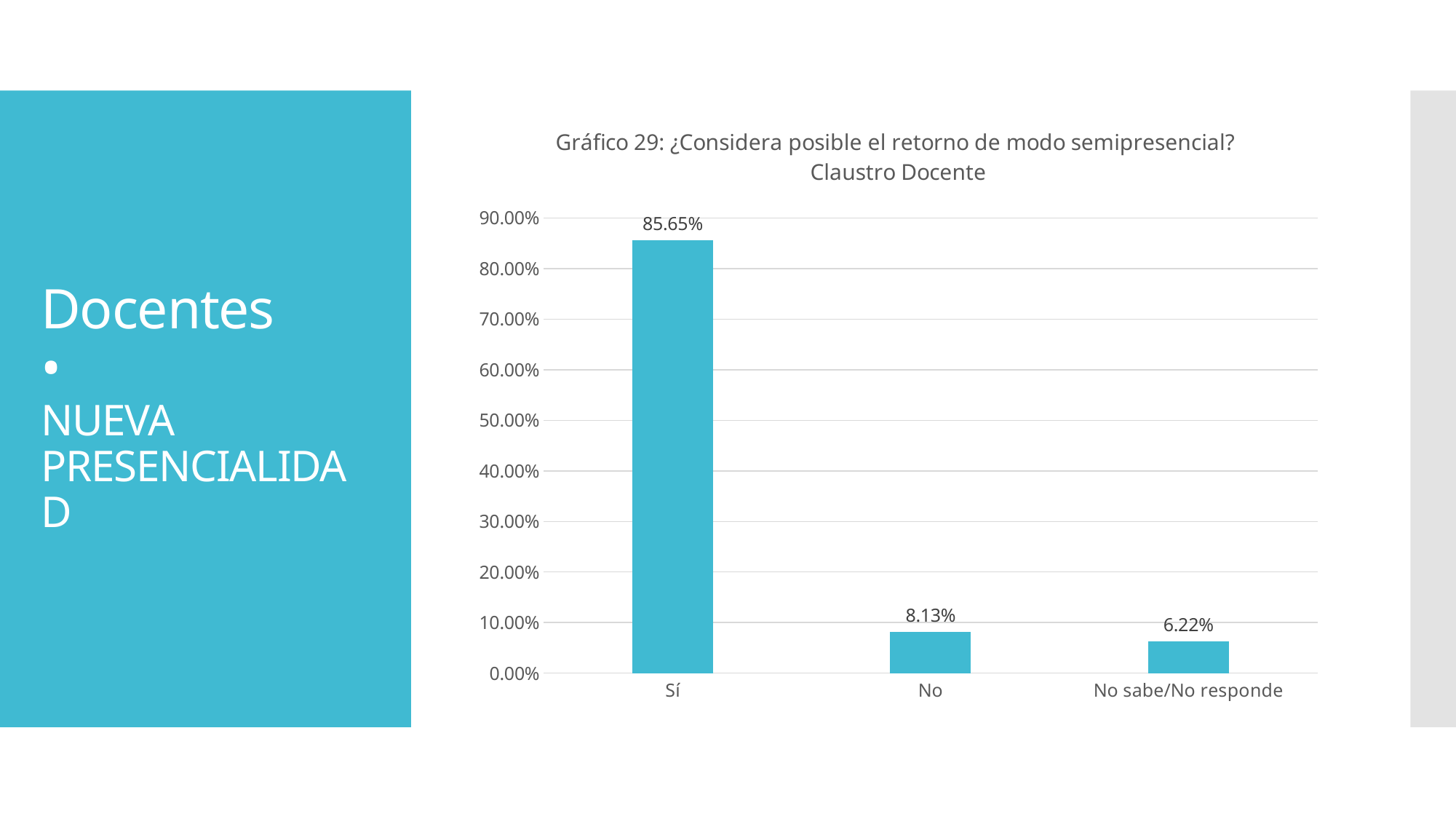
What is the difference between the values for Sí and No? 77.52% What is the value for Sí? 85.65% What is the difference between the values for No and No sabe/No responde? 1.91% What is the title of the chart? Gráfico 29: ¿Considera posible el retorno de modo semipresencial? Claustro Docente Is the value for Sí greater or less than 80.00%? greater Which category has the lowest value? No sabe/No responde Which is larger, the value for No or the value for No sabe/No responde? No What is the value for No? 8.13% How many categories are shown on the x axis? 3 Which category has the highest value? Sí What kind of chart is shown on the slide? bar chart What is the value for No sabe/No responde? 6.22%